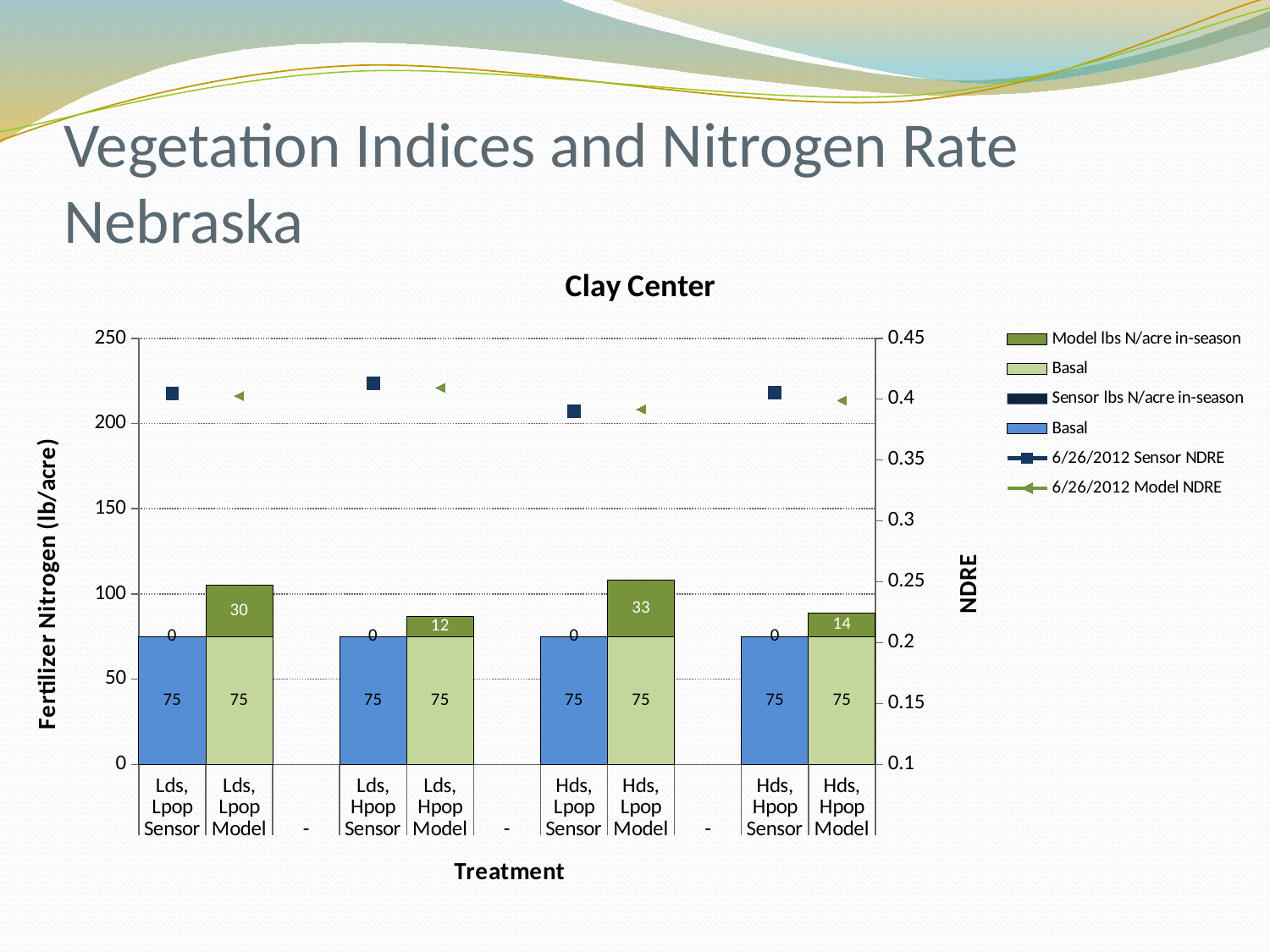
In the Clay Center chart, is the Model in-season value for Hds, Hpop Model larger or smaller than that for Lds, Lpop Model? smaller In the Clay Center chart, what is the Model lbs N/acre in-season value for the Lds, Hpop Model treatment? 12 In the Clay Center chart, what is the total fertilizer nitrogen for the Hds, Lpop Model bar (Basal plus Model in-season)? 108 In the Clay Center chart, which treatment has the lowest Model lbs N/acre in-season value? Lds, Hpop Model In the Clay Center chart, what is the difference between the Model in-season values for Lds, Lpop Model and Lds, Hpop Model? 18 What is the title of the chart on the slide? Clay Center In the Clay Center chart, what is the total fertilizer nitrogen for the Lds, Lpop Model bar (Basal plus Model in-season)? 105 How many series does the legend of the Clay Center chart list? 6 In the Clay Center chart, what is the Model lbs N/acre in-season value for the Hds, Lpop Model treatment? 33 In the Clay Center chart, is the 6/26/2012 Sensor NDRE value for the Hds, Lpop Sensor treatment greater or less than 0.4? less In the Clay Center chart, which treatment has the highest Model lbs N/acre in-season value? Hds, Lpop Model In the Clay Center chart, what is the Basal value for the Lds, Hpop Sensor treatment? 75